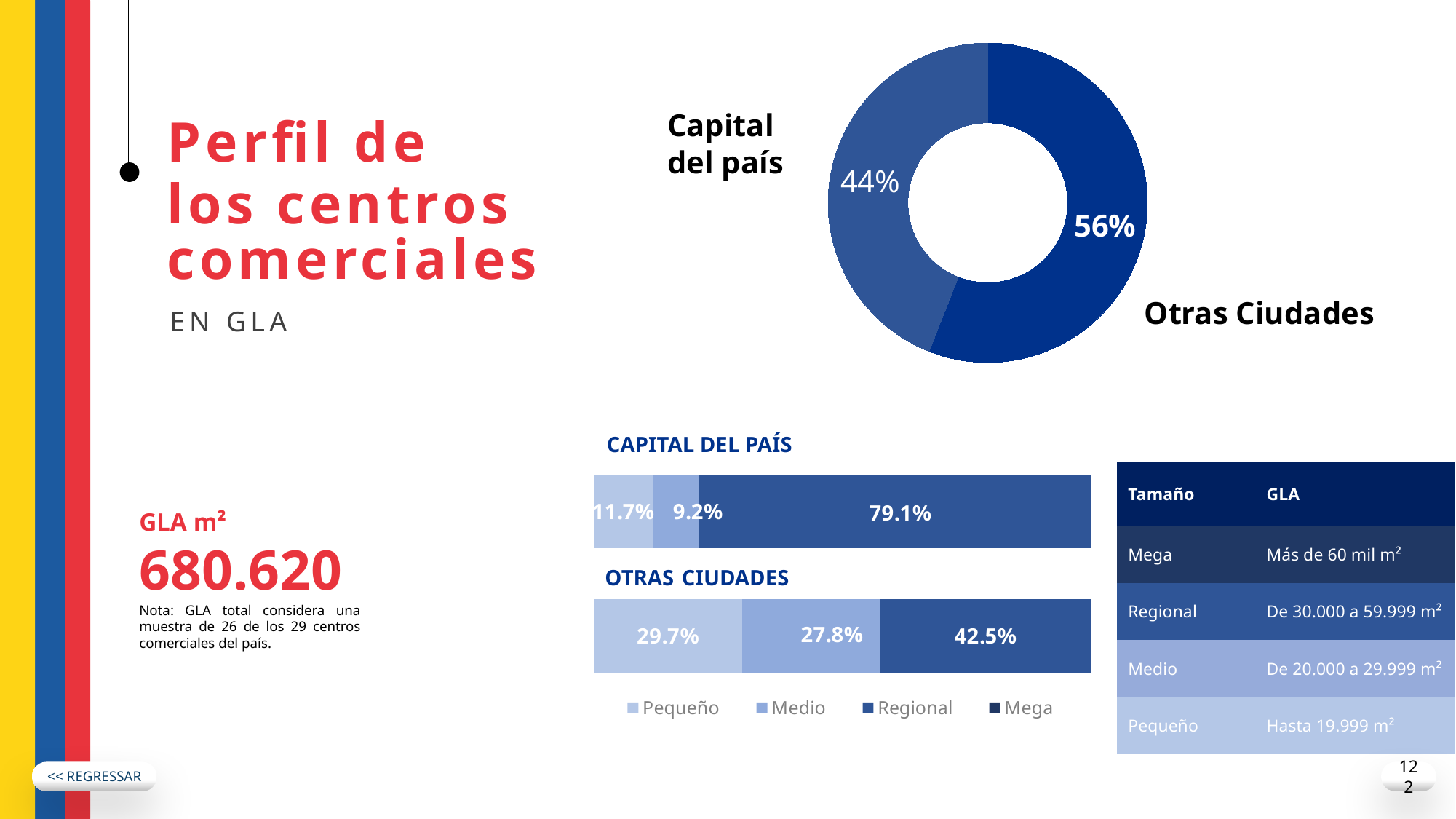
In the donut chart at the top, what share is labelled for Capital del país? 44% What are the series names listed in the legend below the stacked bar charts? Pequeño, Medio, Regional, Mega In the donut chart at the top, what is the difference in percentage points between Otras Ciudades and Capital del país? 12 percentage points In the donut chart at the top, what share is labelled for Otras Ciudades? 56% In the stacked bar chart titled CAPITAL DEL PAÍS, what is the value of the smallest segment? 9.2% How many series does the legend below the stacked bar charts list? 4 In the donut chart at the top, how many categories are shown? 2 In the stacked bar chart titled OTRAS CIUDADES, what is the value of the leftmost segment? 29.7% What kind of chart is the chart at the top of the slide? Donut (pie) chart In the stacked bar chart titled CAPITAL DEL PAÍS, what is the value of the largest segment? 79.1% In the donut chart at the top, which category has the larger share, Capital del país or Otras Ciudades? Otras Ciudades In the stacked bar chart titled OTRAS CIUDADES, what is the value of the largest segment? 42.5%